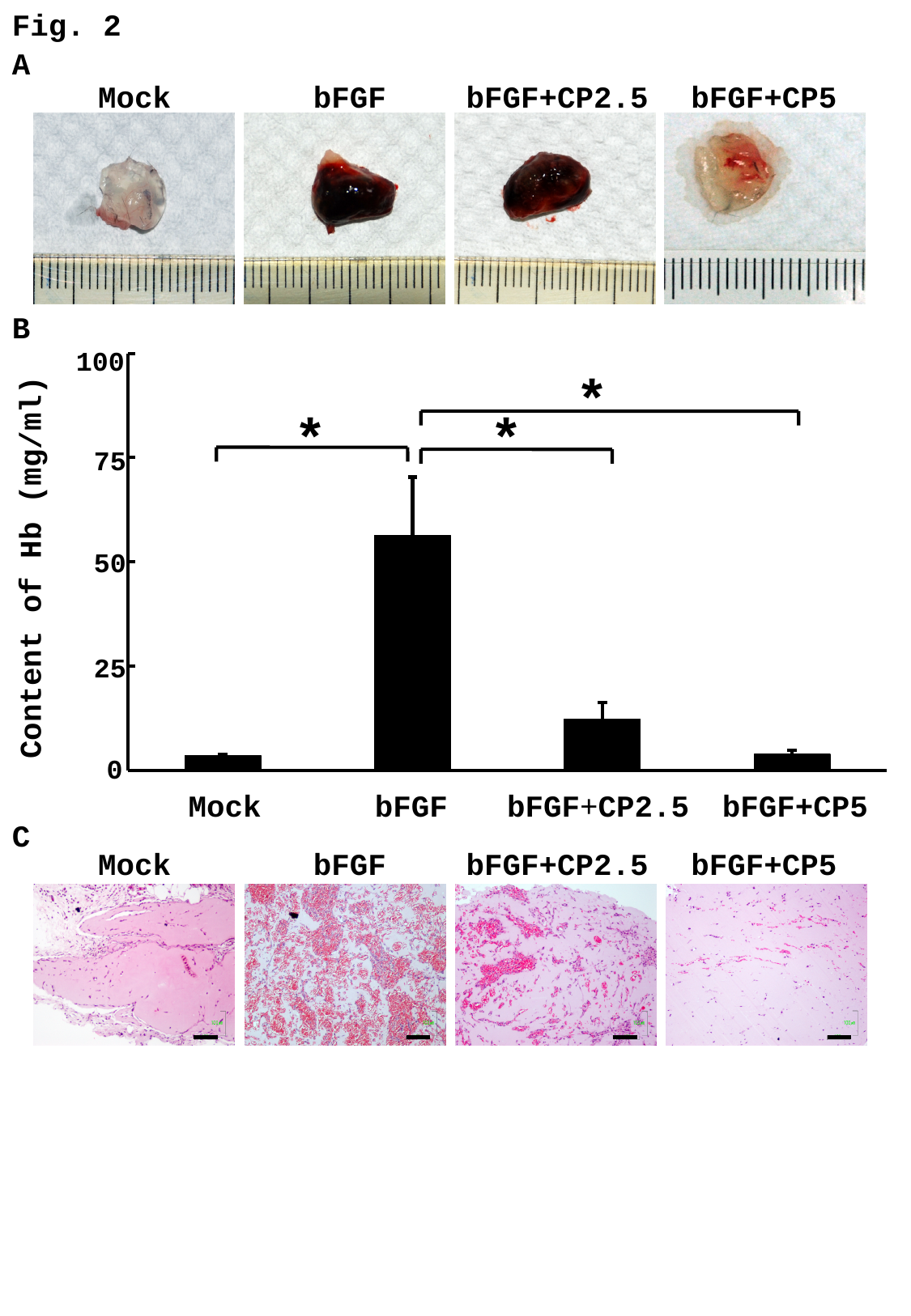
What is the maximum value shown on the y axis of the bar chart in panel B? 100 How many categories are shown on the x axis of the bar chart in panel B? 4 In the bar chart in panel B, is the value for bFGF greater or less than 50? greater In the bar chart in panel B, is the value for bFGF+CP2.5 greater or less than 25? less In the bar chart in panel B, which category has the highest content of Hb? bFGF In the bar chart in panel B, which is larger, the value for bFGF+CP2.5 or the value for bFGF+CP5? bFGF+CP2.5 In the bar chart in panel B, which is larger, the value for bFGF or the value for bFGF+CP2.5? bFGF In the bar chart in panel B, is the value for bFGF greater or less than 75? less What is the y-axis label of the bar chart in panel B? Content of Hb (mg/ml) What kind of chart is shown in panel B? bar chart